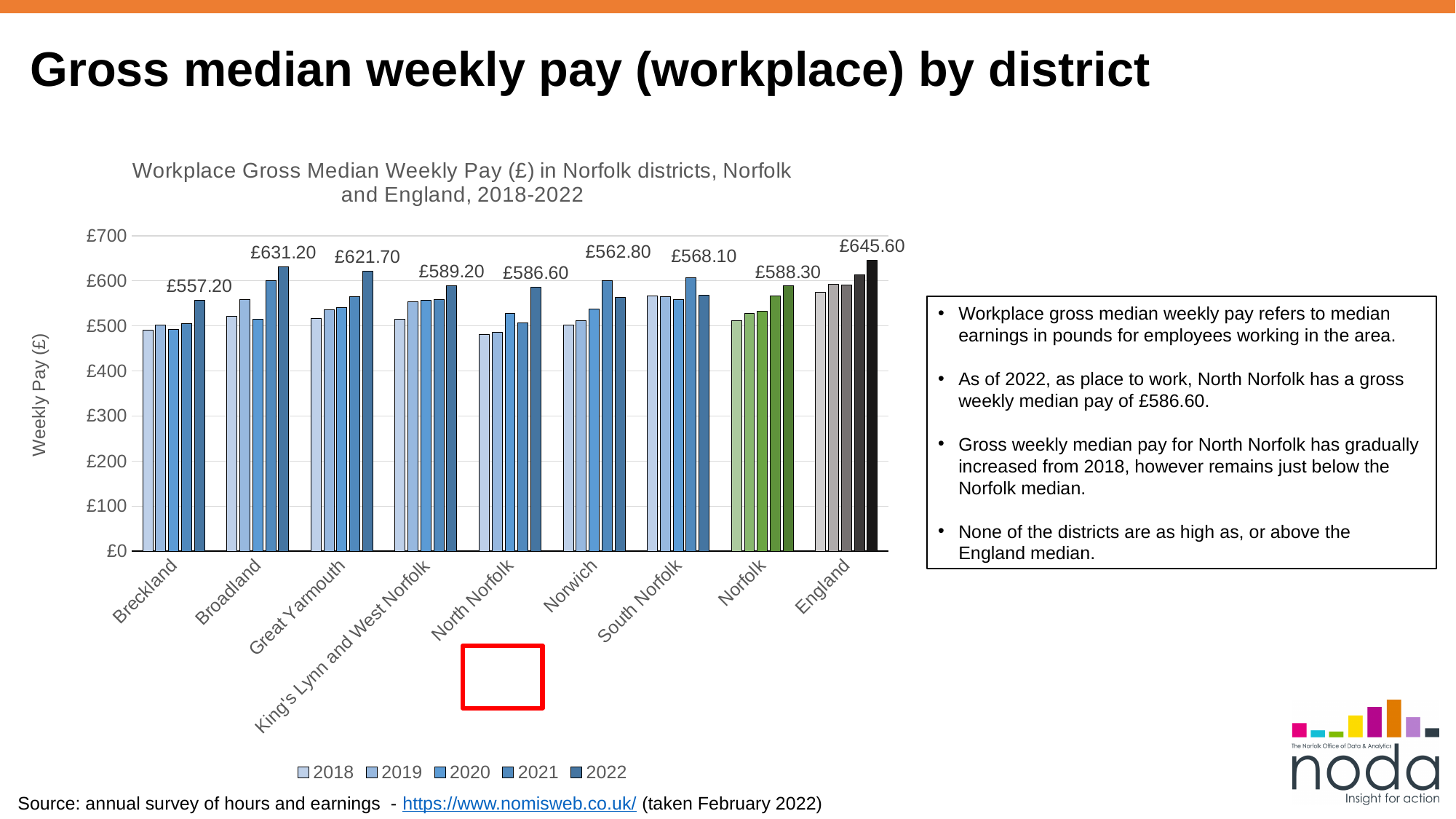
How many series does the legend list? 5 Is the 2018 value for North Norfolk greater or less than £500? less What type of chart is shown on the slide? Bar chart How many categories are shown on the x axis? 9 What is the 2022 gross median weekly pay for Broadland? £631.20 Which has the higher 2022 value, Broadland or Great Yarmouth? Broadland Which category has the lowest 2022 gross median weekly pay? Breckland What is the difference between the 2022 values for Broadland and Breckland? £74.00 What is the difference between the 2022 values for England and North Norfolk? £59.00 What is the 2022 gross median weekly pay for England? £645.60 Which category has the highest 2022 gross median weekly pay? England What is the 2022 gross median weekly pay for North Norfolk? £586.60